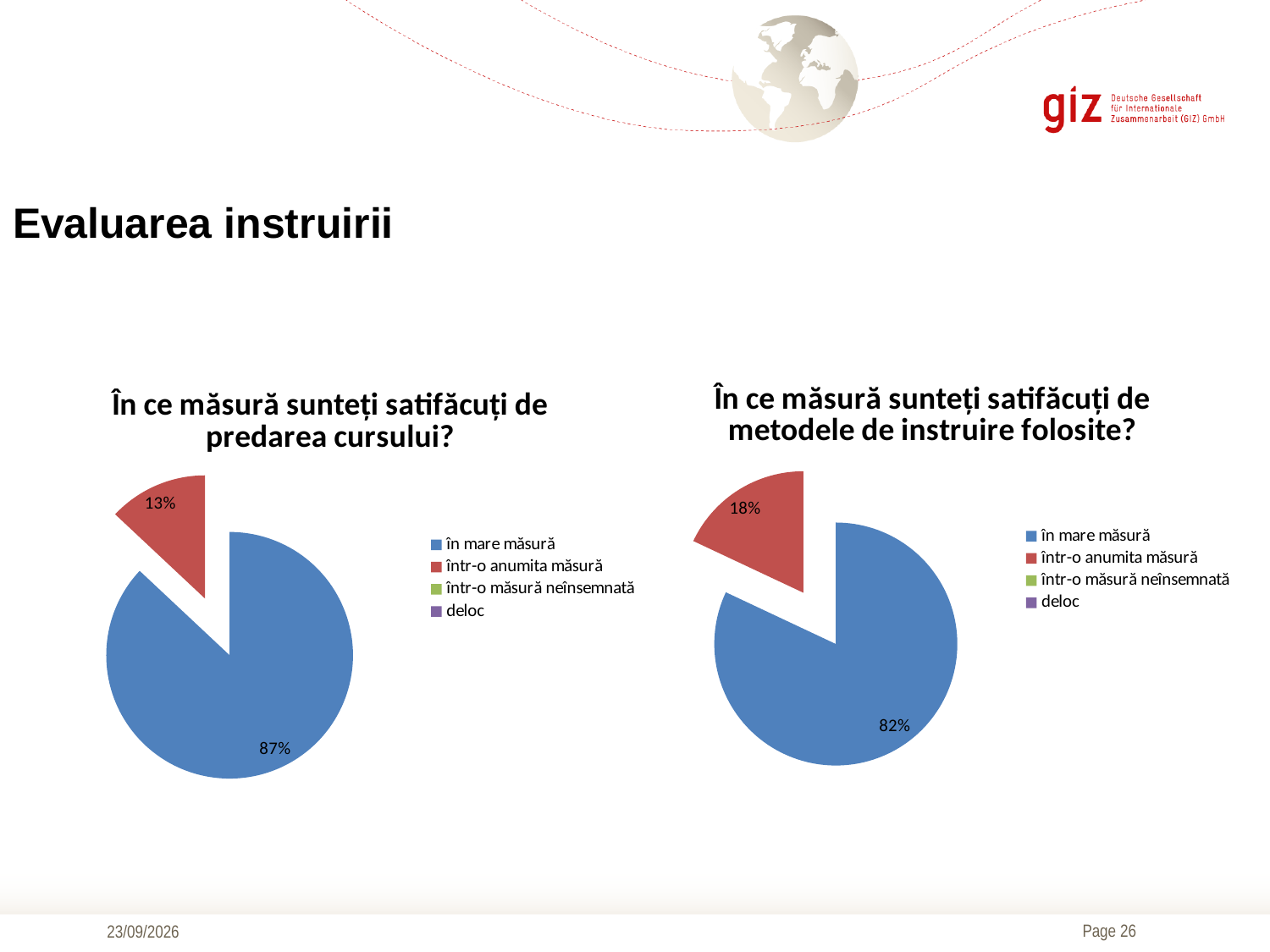
How many entries does the legend of the right chart about 'metodele de instruire folosite' list? 4 In the right chart about 'metodele de instruire folosite', which labelled category has the smallest slice? într-o anumita măsură In the left chart titled 'În ce măsură sunteți satifăcuți de predarea cursului?', what share is labelled for 'într-o anumita măsură'? 13% In the left chart titled 'În ce măsură sunteți satifăcuți de predarea cursului?', what share is labelled for 'în mare măsură'? 87% What type of chart is used for 'În ce măsură sunteți satifăcuți de predarea cursului?'? pie chart In the left chart about 'predarea cursului', what is the difference in percentage points between the 'în mare măsură' and 'într-o anumita măsură' slices? 74 In the right chart about 'metodele de instruire folosite', what is the difference in percentage points between the 'în mare măsură' and 'într-o anumita măsură' slices? 64 Which chart has the larger 'în mare măsură' share: the left chart about 'predarea cursului' or the right chart about 'metodele de instruire folosite'? the left chart about 'predarea cursului' In the left chart about 'predarea cursului', what colour is the slice for 'în mare măsură'? blue In the right chart titled 'În ce măsură sunteți satifăcuți de metodele de instruire folosite?', what share is labelled for 'în mare măsură'? 82% In the left chart about 'predarea cursului', which category has the largest slice? în mare măsură In the right chart titled 'În ce măsură sunteți satifăcuți de metodele de instruire folosite?', what share is labelled for 'într-o anumita măsură'? 18%